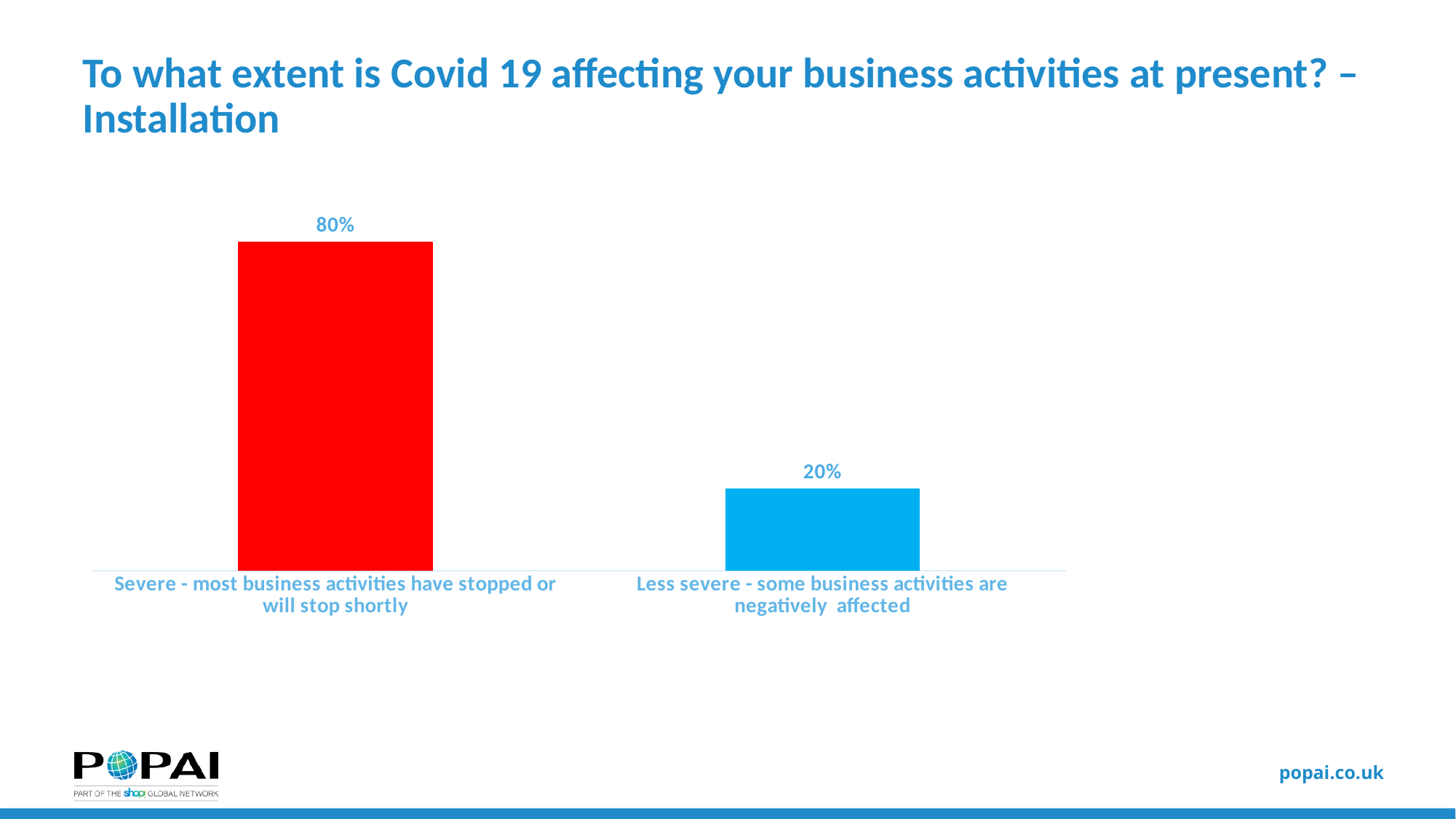
How many categories are shown in the chart? 2 Which is larger: the value for 'Severe' or the value for 'Less severe'? Severe What is the difference in percentage points between the 'Severe' and 'Less severe' categories? 60 percentage points What type of chart is shown on the slide? Bar chart What is the total of the two percentages shown in the chart? 100% What colour is the bar for the 'Severe' category? Red Which category has the lowest value? Less severe - some business activities are negatively affected What percentage of respondents said the impact was 'Less severe - some business activities are negatively affected'? 20% Which business segment does the chart title say the results are for? Installation What percentage of respondents said the impact was 'Severe - most business activities have stopped or will stop shortly'? 80% Which category has the highest value? Severe - most business activities have stopped or will stop shortly